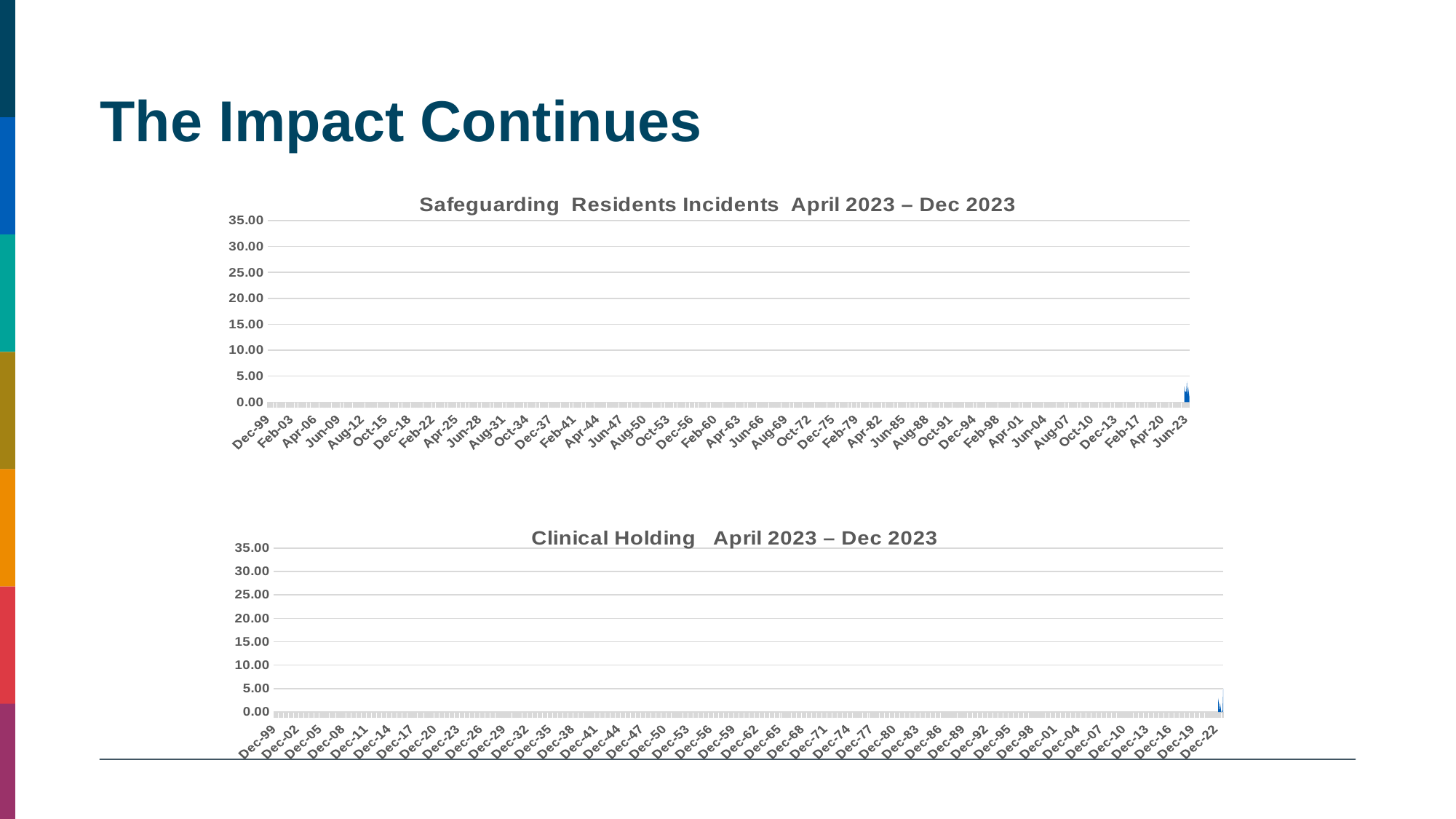
In the 'Safeguarding Residents Incidents April 2023 – Dec 2023' chart, is the value for Jun-23 greater or less than 5.00? less What kind of chart is the 'Safeguarding Residents Incidents April 2023 – Dec 2023' chart? area chart What kind of chart is the 'Clinical Holding April 2023 – Dec 2023' chart? area chart What is the title of the bottom chart on the slide? Clinical Holding April 2023 – Dec 2023 What is the title of the top chart on the slide? Safeguarding Residents Incidents April 2023 – Dec 2023